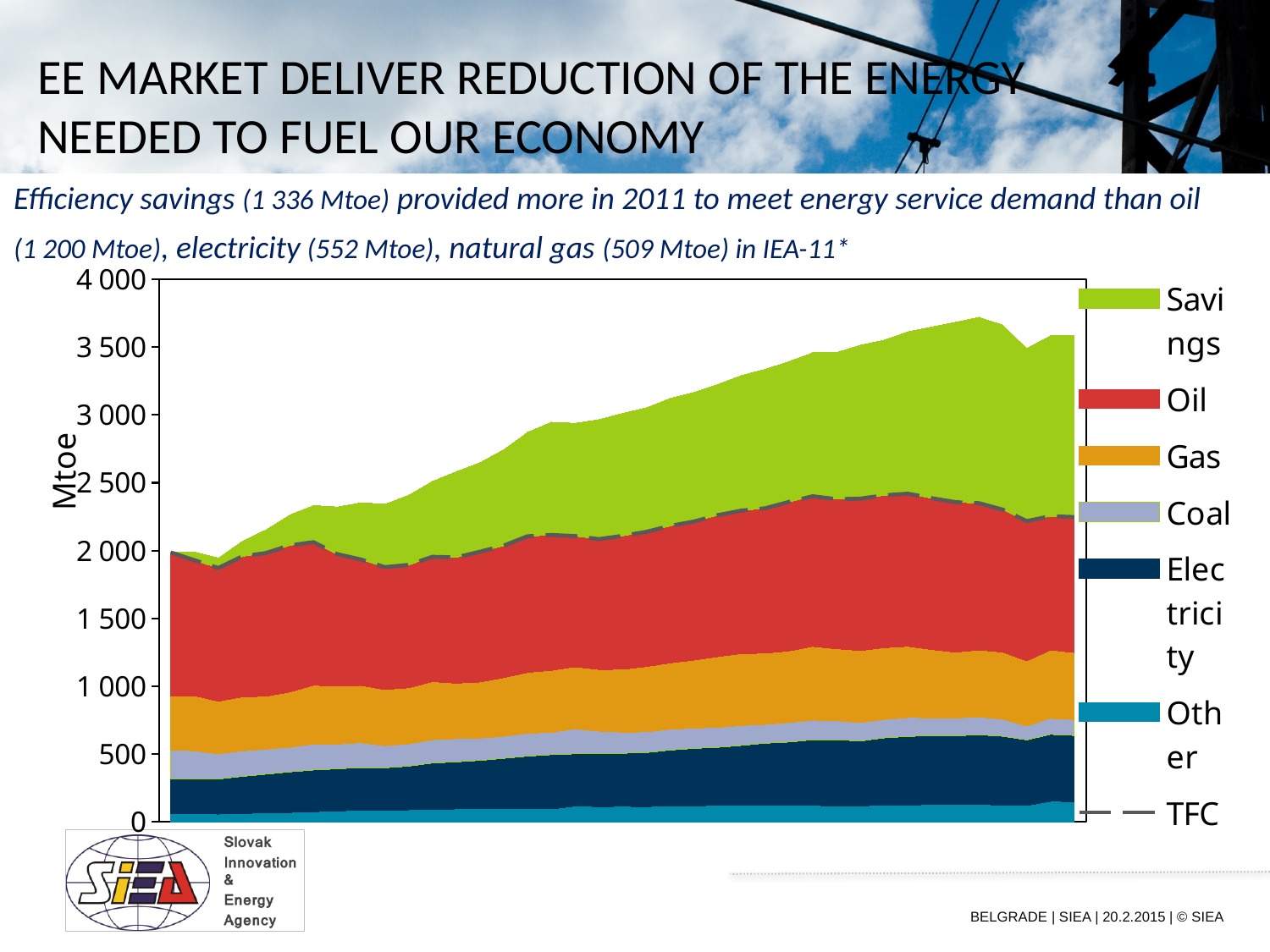
How many entries does the chart legend list? 7 Is the TFC dashed line at the right-hand end of the chart greater or less than 2 500 Mtoe? less What kind of chart is shown on the slide? Stacked area chart Does the total height of the stacked areas rise or fall from the left of the chart to the right? Rise Is the top of the stacked areas at the right-hand end of the chart greater or less than 3 000 Mtoe? greater What is the label on the vertical axis of the chart? Mtoe Is the highest point reached by the top of the stacked areas greater or less than 3 500 Mtoe? greater What is the highest value shown on the vertical axis of the chart? 4 000 Which legend entry is drawn as a dashed line rather than a filled area? TFC At the right-hand end of the chart, which band is thicker: Savings or Oil? Savings At the right-hand end of the chart, which band is thicker: Gas or Coal? Gas